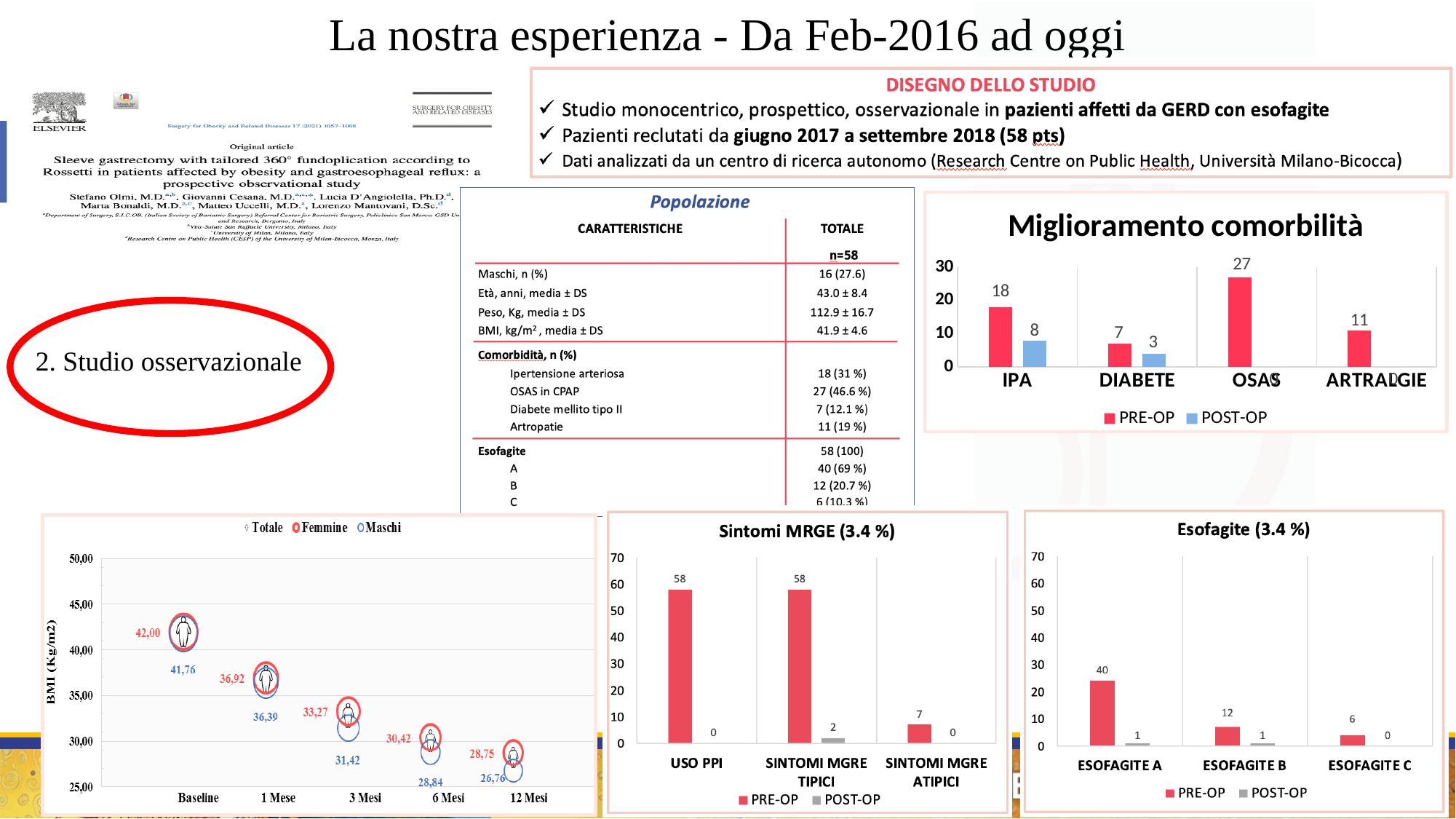
In the 'Esofagite (3.4 %)' chart, what is the PRE-OP value for ESOFAGITE A? 40 In the BMI chart at the bottom left, what is the Maschi value at 12 Mesi? 26,76 In the 'Esofagite (3.4 %)' chart, which category has the lowest PRE-OP value? ESOFAGITE C In the 'Sintomi MRGE (3.4 %)' chart, what is the POST-OP value for SINTOMI MGRE TIPICI? 2 In the 'Sintomi MRGE (3.4 %)' chart, what is the PRE-OP value for SINTOMI MGRE ATIPICI? 7 In the 'Miglioramento comorbilità' chart, what is the PRE-OP value for IPA? 18 In the 'Miglioramento comorbilità' chart, what is the POST-OP value for DIABETE? 3 In the 'Miglioramento comorbilità' chart, what is the difference between the PRE-OP and POST-OP values for IPA? 10 In the 'Miglioramento comorbilità' chart, which category has the highest PRE-OP value? OSAS In the BMI chart at the bottom left, how many series does the legend list? 3 In the 'Esofagite (3.4 %)' chart, how many categories are shown on the x axis? 3 In the BMI chart at the bottom left, do the Femmine values rise or fall from Baseline to 12 Mesi? fall